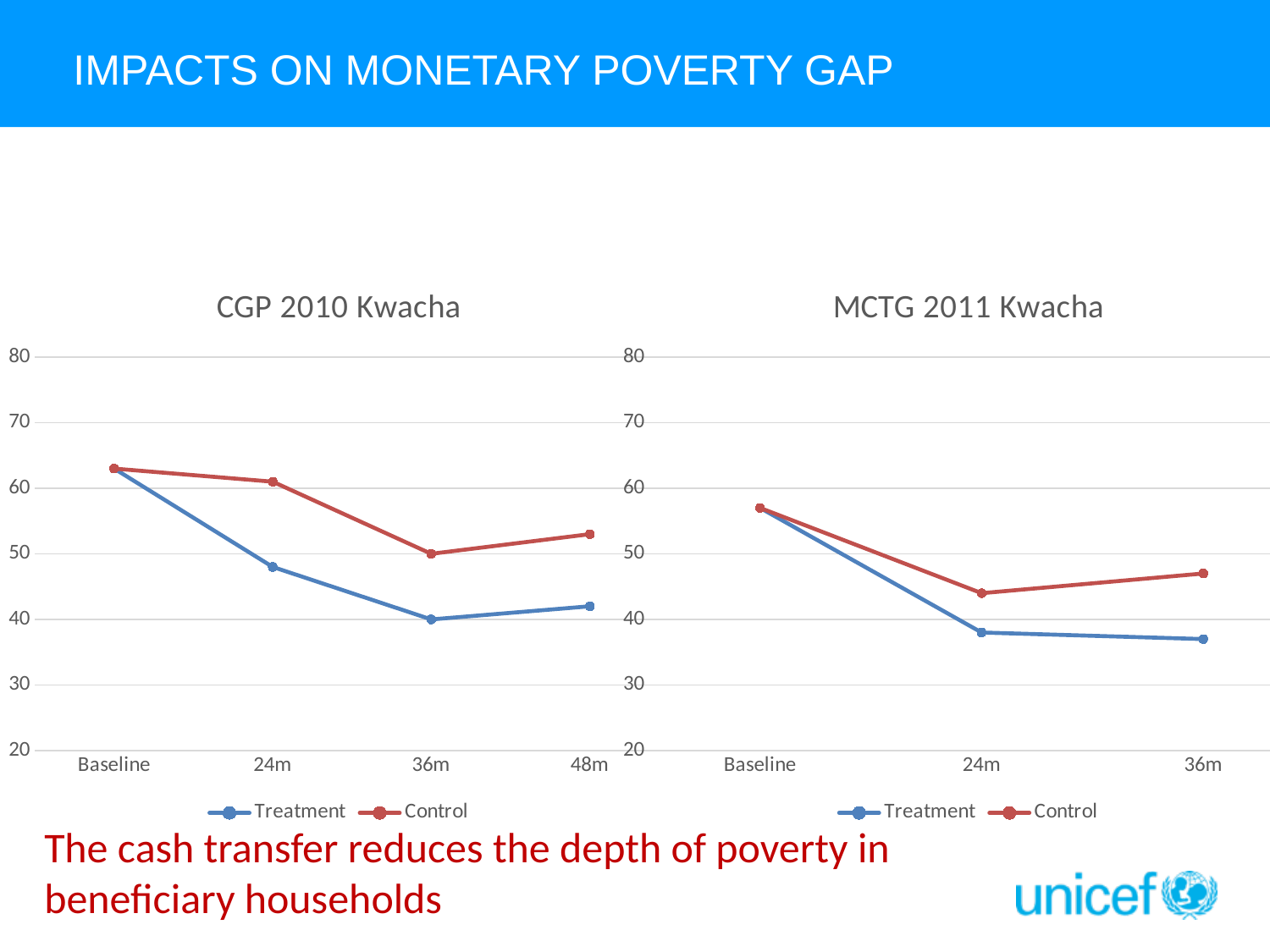
In the MCTG 2011 Kwacha chart, is the Control value at 36m greater or less than 50? less In the MCTG 2011 Kwacha chart, is the Treatment value at 24m greater or less than 40? less What kind of chart is the CGP 2010 Kwacha chart? line chart In the CGP 2010 Kwacha chart, is the Control value at 48m greater or less than 50? greater In the MCTG 2011 Kwacha chart, at which time point is the Control value lowest? 24m In the CGP 2010 Kwacha chart, at which time point is the Treatment value highest? Baseline In the MCTG 2011 Kwacha chart, which colour is used for the Control series? red In the CGP 2010 Kwacha chart, does the Treatment line rise or fall from Baseline to 36m? fall In the MCTG 2011 Kwacha chart, how many time points are shown on the x axis? 3 How many series does the legend of the MCTG 2011 Kwacha chart list? 2 In the CGP 2010 Kwacha chart, how many time points are shown on the x axis? 4 In the CGP 2010 Kwacha chart, which series has the higher value at 48m, Treatment or Control? Control